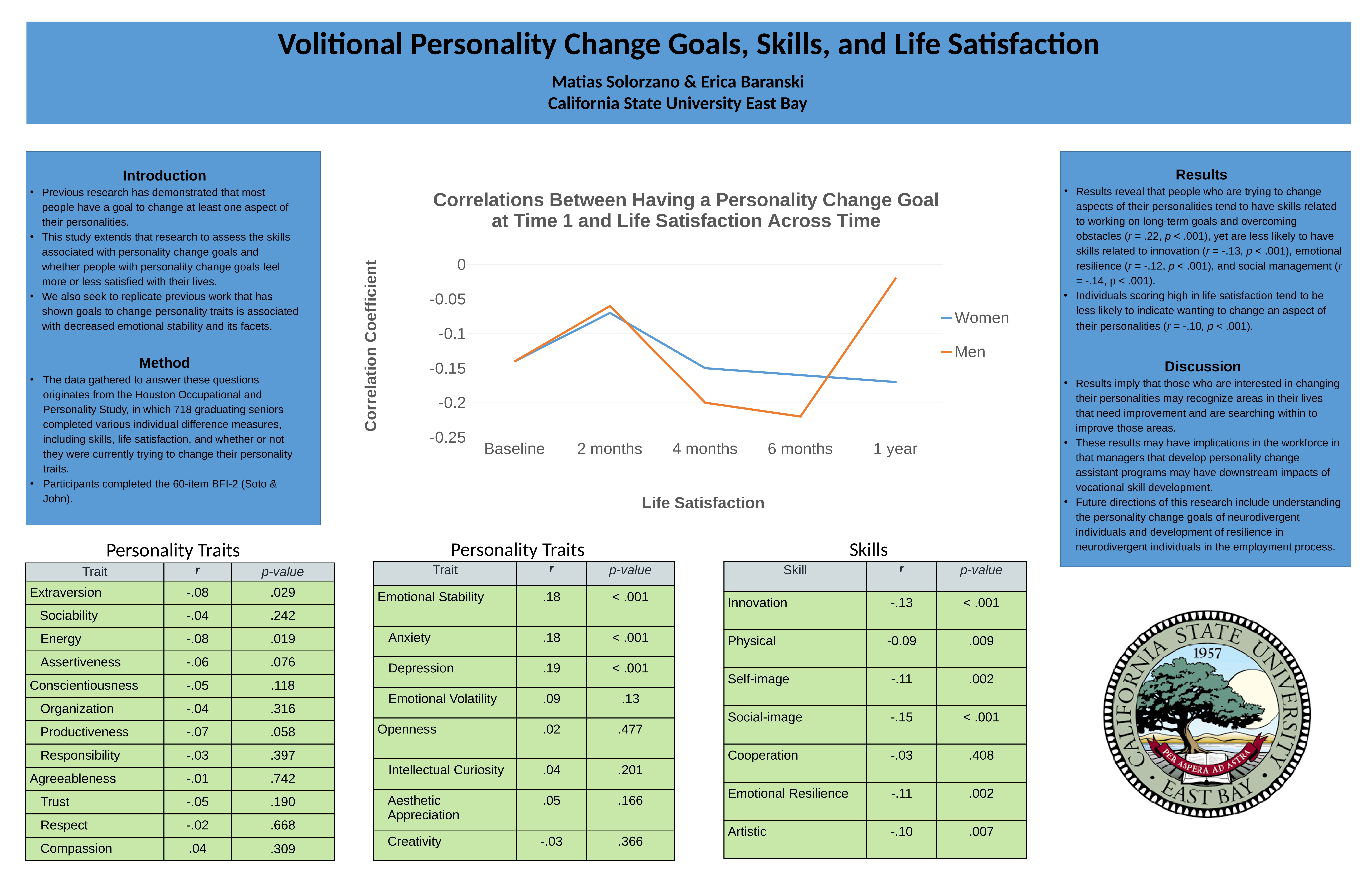
At 6 months, which series has the higher correlation coefficient, Women or Men? Women What kind of chart is shown on the slide? line chart How many series does the chart legend list? 2 Is the value for Men at 6 months greater or less than -0.2? less At which time point does the Women series reach its highest correlation coefficient? 2 months Does the Women series rise or fall from 2 months to 1 year? fall How many time points are plotted along the x axis of the chart? 5 Is the value for Men at 1 year greater or less than -0.05? greater At 1 year, which series has the higher correlation coefficient, Women or Men? Men At which time point does the Men series reach its lowest correlation coefficient? 6 months Is the value for Women at 1 year greater or less than -0.15? less At which time point does the Men series reach its highest correlation coefficient? 1 year